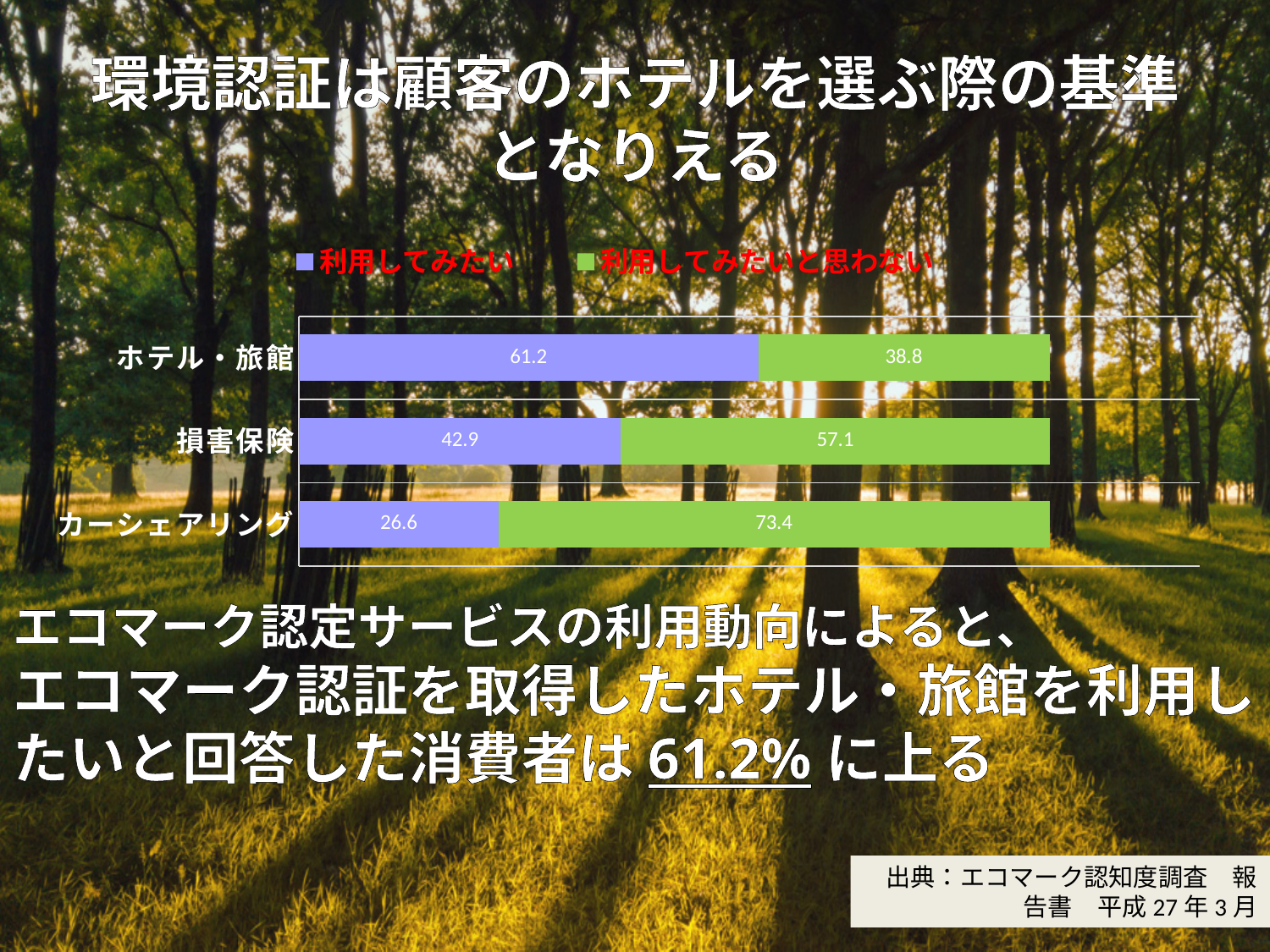
How many categories are shown in the chart? 3 What is the value of 利用してみたいと思わない for カーシェアリング? 73.4 Which category has the highest value for 利用してみたい? ホテル・旅館 Which is larger for 損害保険: 利用してみたい or 利用してみたいと思わない? 利用してみたいと思わない What is the difference between the 利用してみたい values for ホテル・旅館 and カーシェアリング? 34.6 What is the total of the stacked bar for 損害保険? 100 Which category has the lowest value for 利用してみたい? カーシェアリング What is the value of 利用してみたい for ホテル・旅館? 61.2 How many series does the legend list? 2 What kind of chart is shown on the slide? Stacked bar chart What is the value of 利用してみたい for 損害保険? 42.9 What is the value of 利用してみたいと思わない for ホテル・旅館? 38.8